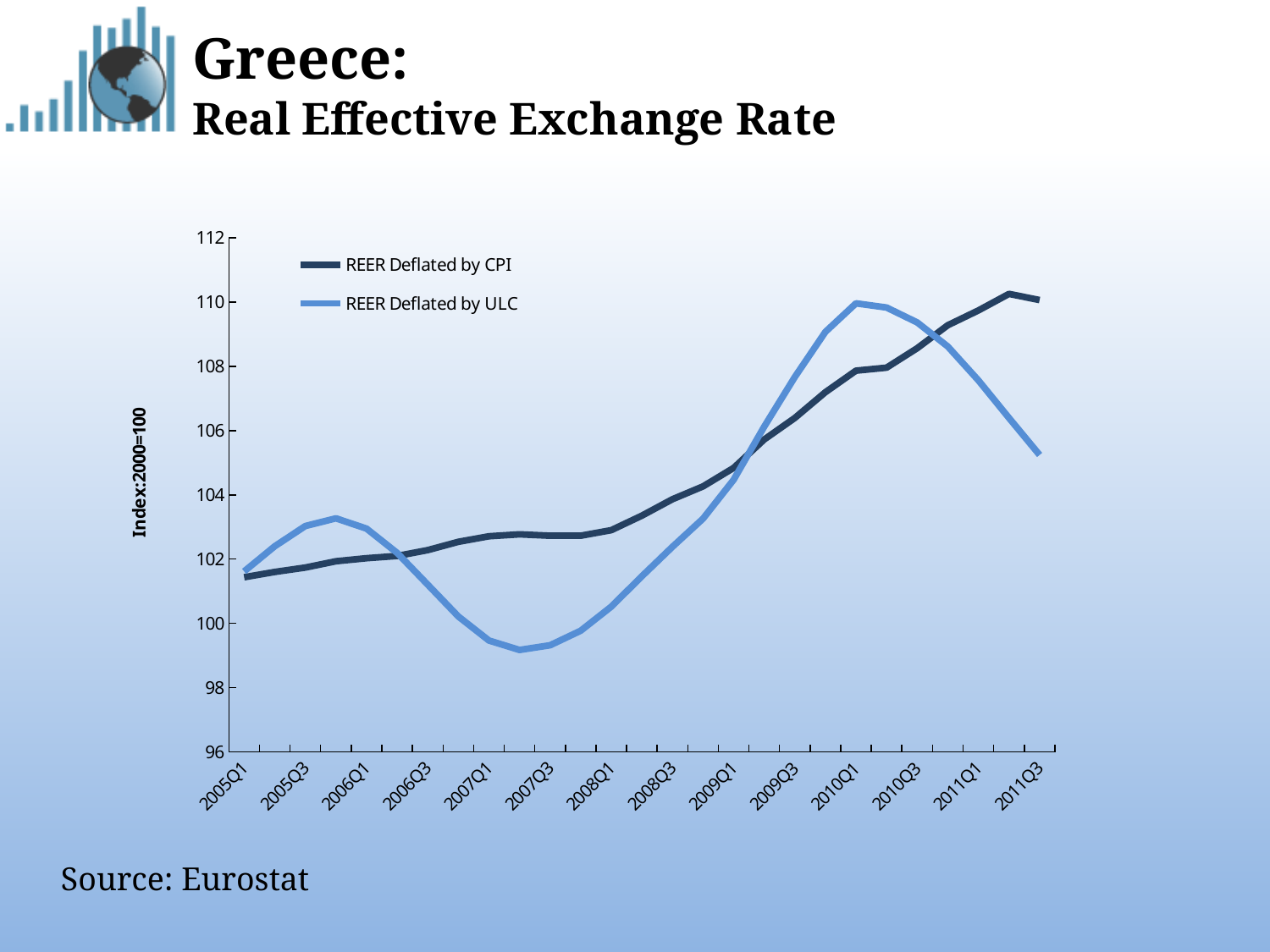
What kind of chart is shown on the slide? line chart At 2011Q3, which series has the higher value, REER Deflated by CPI or REER Deflated by ULC? REER Deflated by CPI What is the label on the vertical axis? Index:2000=100 In which year does the REER Deflated by ULC series reach its highest point? 2010 Is the value of REER Deflated by CPI at 2011Q3 greater or less than 108? greater Is the value of REER Deflated by CPI at 2008Q1 greater or less than 104? less At 2010Q1, which series has the higher value, REER Deflated by CPI or REER Deflated by ULC? REER Deflated by ULC Is the value of REER Deflated by ULC at 2010Q1 greater or less than 108? greater How many series does the legend list? 2 Does the REER Deflated by ULC series rise or fall between 2010Q1 and 2011Q3? fall What are the two series named in the legend? REER Deflated by CPI; REER Deflated by ULC